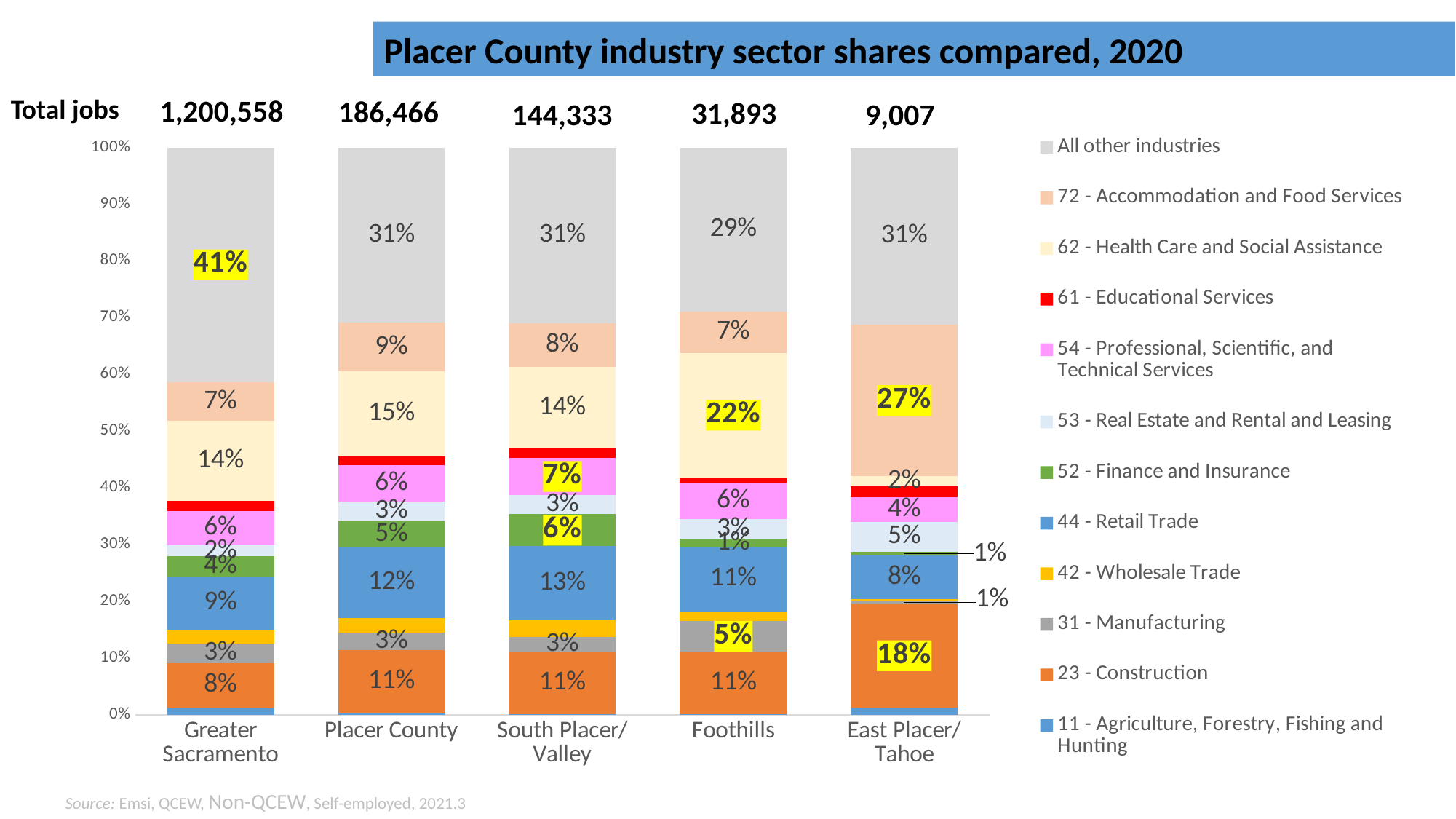
Which is larger, the Retail Trade share in Placer County or in East Placer/Tahoe? Placer County Which area has the smallest share for Health Care and Social Assistance? East Placer/Tahoe What is the share of Accommodation and Food Services in East Placer/Tahoe? 27% What is the share of Retail Trade in South Placer/Valley? 13% How many areas are compared on the x axis? 5 What kind of chart is shown? Stacked bar chart How many industry sectors does the legend list? 12 What is the difference between the Construction share in East Placer/Tahoe and in Greater Sacramento? 10% What is the total number of jobs shown for Placer County? 186,466 Which area has the largest share for All other industries? Greater Sacramento What is the share of Health Care and Social Assistance in Foothills? 22% What is the share of Construction in East Placer/Tahoe? 18%